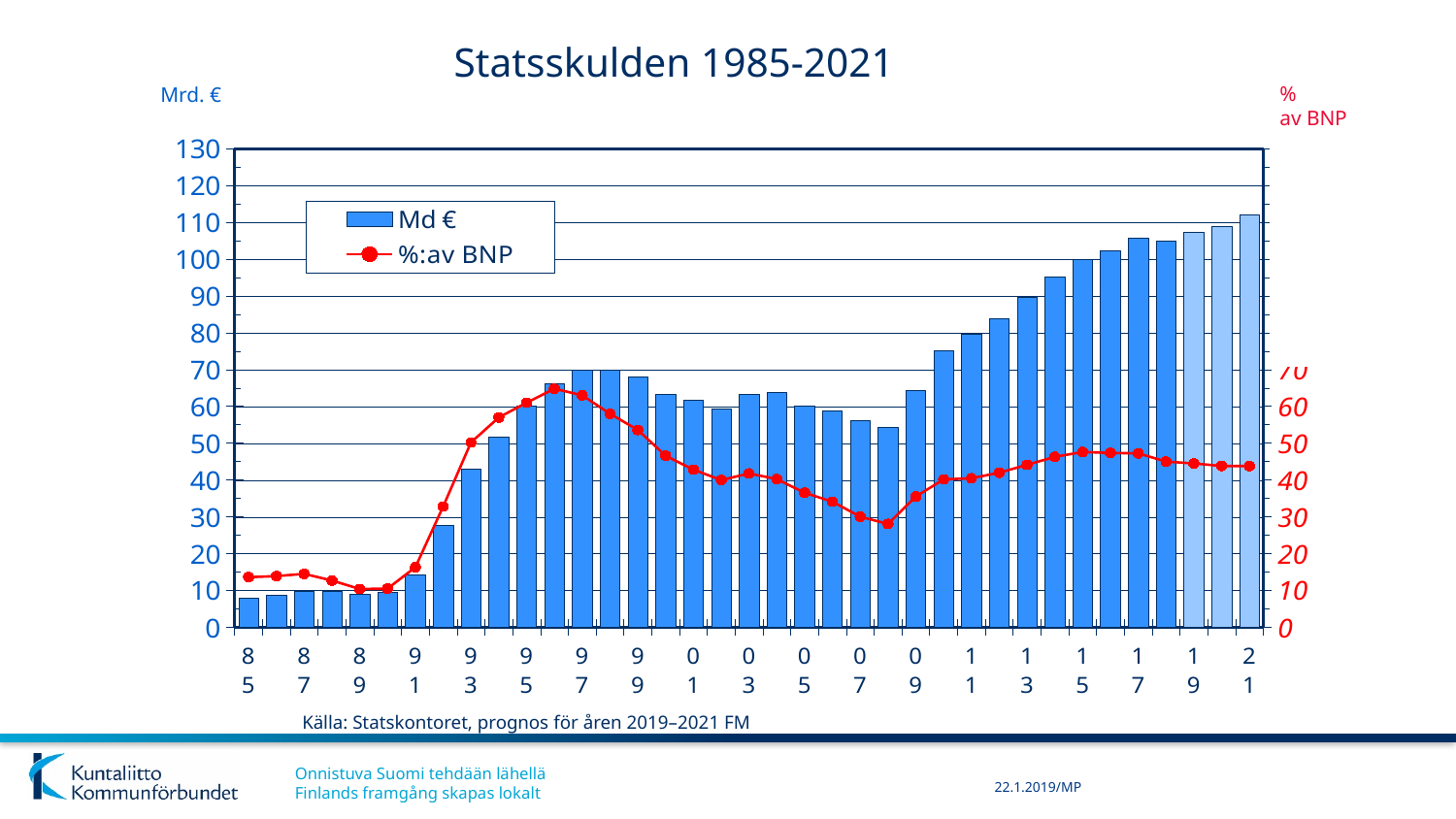
In which year does the %:av BNP line reach its highest point? 1996 What is the title of the chart? Statsskulden 1985-2021 Is the Md € value for 1985 greater or less than 10? less Which is larger, the Md € bar for 1997 or the Md € bar for 2009? 1997 Do the Md € bars rise or fall from 2009 to 2021? rise What are the two series named in the legend? Md € and %:av BNP Is the Md € value for 2019 greater or less than 100? greater What kind of chart is this? Bar chart combined with a line How many series does the chart legend list? 2 Is the %:av BNP value for 1997 greater or less than 60? greater Which year has the lowest Md € bar? 1985 Which year has the highest Md € bar? 2021